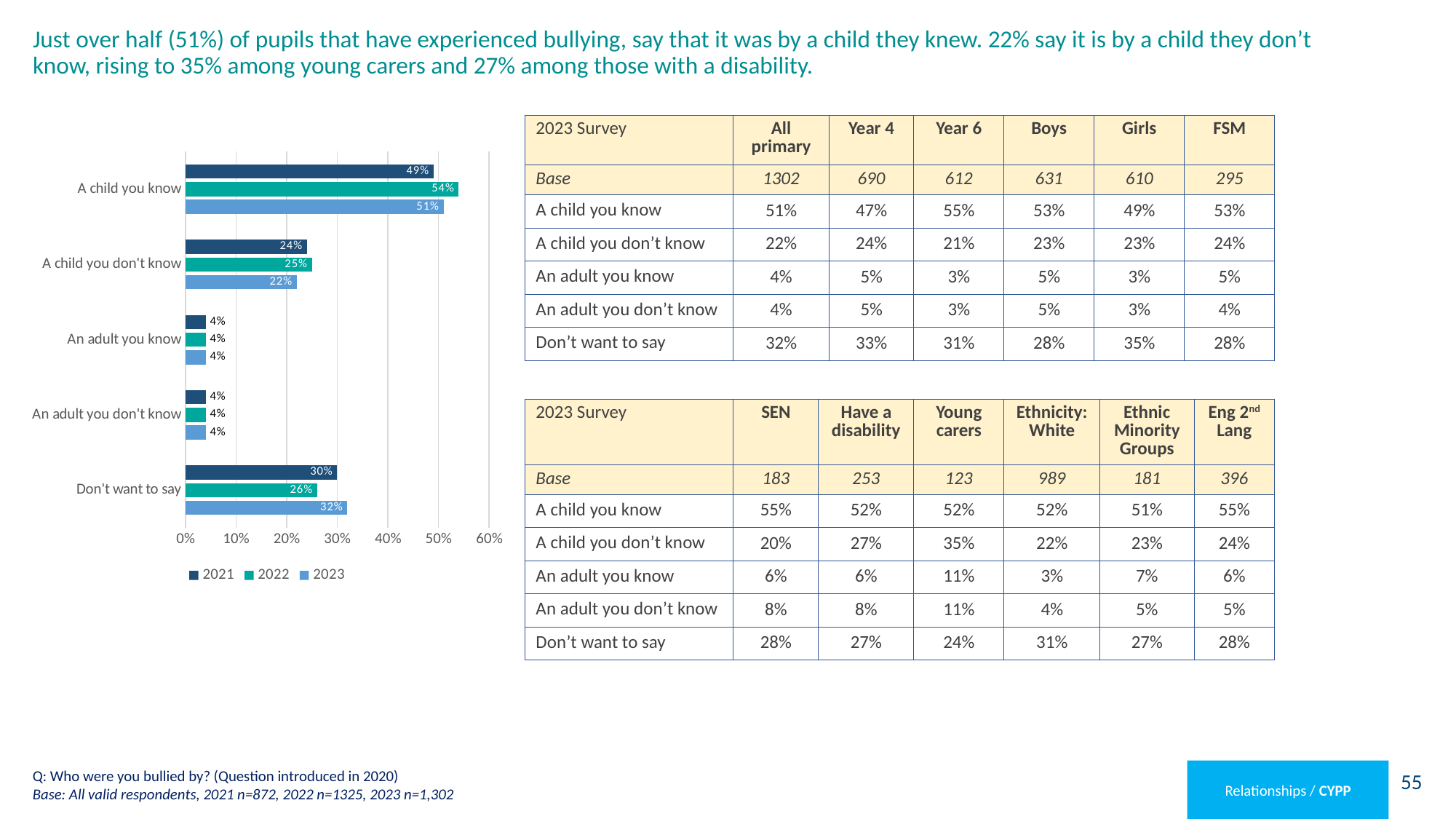
What is the difference between the 2022 and 2021 values for 'A child you know' in the bar chart? 5% Which year has the highest value for 'A child you know' in the bar chart? 2022 What are the series listed in the bar chart's legend? 2021, 2022, 2023 Which category has the highest 2022 value in the bar chart? A child you know In the bar chart, is the 2023 value for 'Don't want to say' larger or smaller than the 2022 value? larger How many categories are shown in the bar chart? 5 What is the 2021 value for 'Don't want to say' in the bar chart? 30% What is the 2023 value for 'A child you know' in the bar chart? 51% What kind of chart is shown on the slide? bar chart What is the difference between the 2023 and 2022 values for 'Don't want to say' in the bar chart? 6% What is the 2022 value for 'A child you don't know' in the bar chart? 25% How many series does the legend of the bar chart list? 3